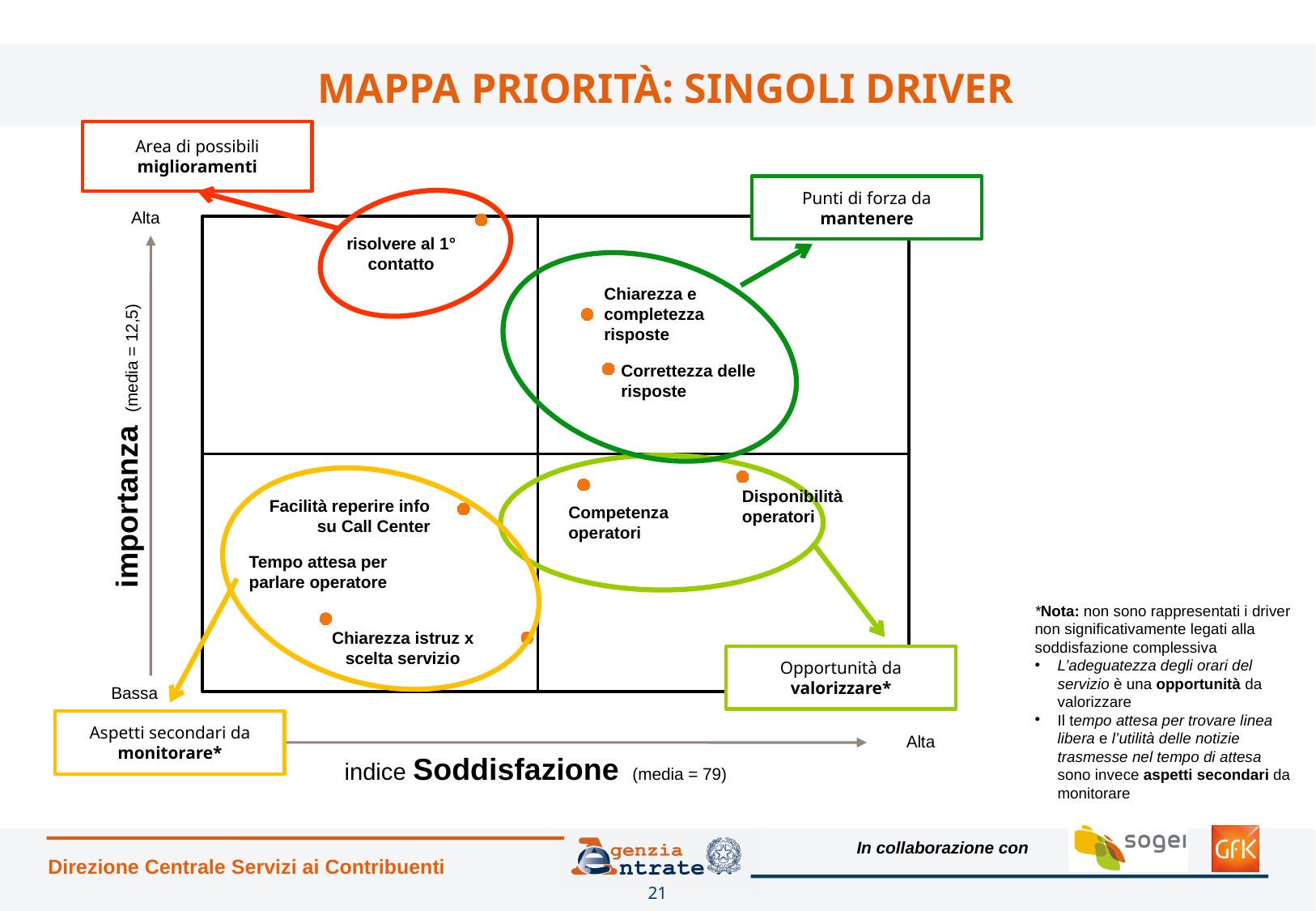
How many labelled drivers are plotted on the priority map? 8 Which driver has the highest importance on the map? risolvere al 1° contatto What is the title of the chart on the slide? MAPPA PRIORITÀ: SINGOLI DRIVER What is the mean value of importance (importanza) shown on the y axis? 12,5 Which driver is plotted in the 'Area di possibili miglioramenti' quadrant (high importance, low satisfaction)? risolvere al 1° contatto Which has a higher importance: 'risolvere al 1° contatto' or 'Chiarezza istruz x scelta servizio'? risolvere al 1° contatto What kind of chart is shown on the slide? scatter chart Which drivers are plotted in the 'Punti di forza da mantenere' quadrant? Chiarezza e completezza risposte; Correttezza delle risposte Which has a higher satisfaction index: 'risolvere al 1° contatto' or 'Correttezza delle risposte'? Correttezza delle risposte What is the mean value of the satisfaction index (indice Soddisfazione) shown on the x axis? 79 Which drivers are plotted in the 'Opportunità da valorizzare' quadrant? Competenza operatori; Disponibilità operatori Which driver has the highest satisfaction index on the map? Disponibilità operatori